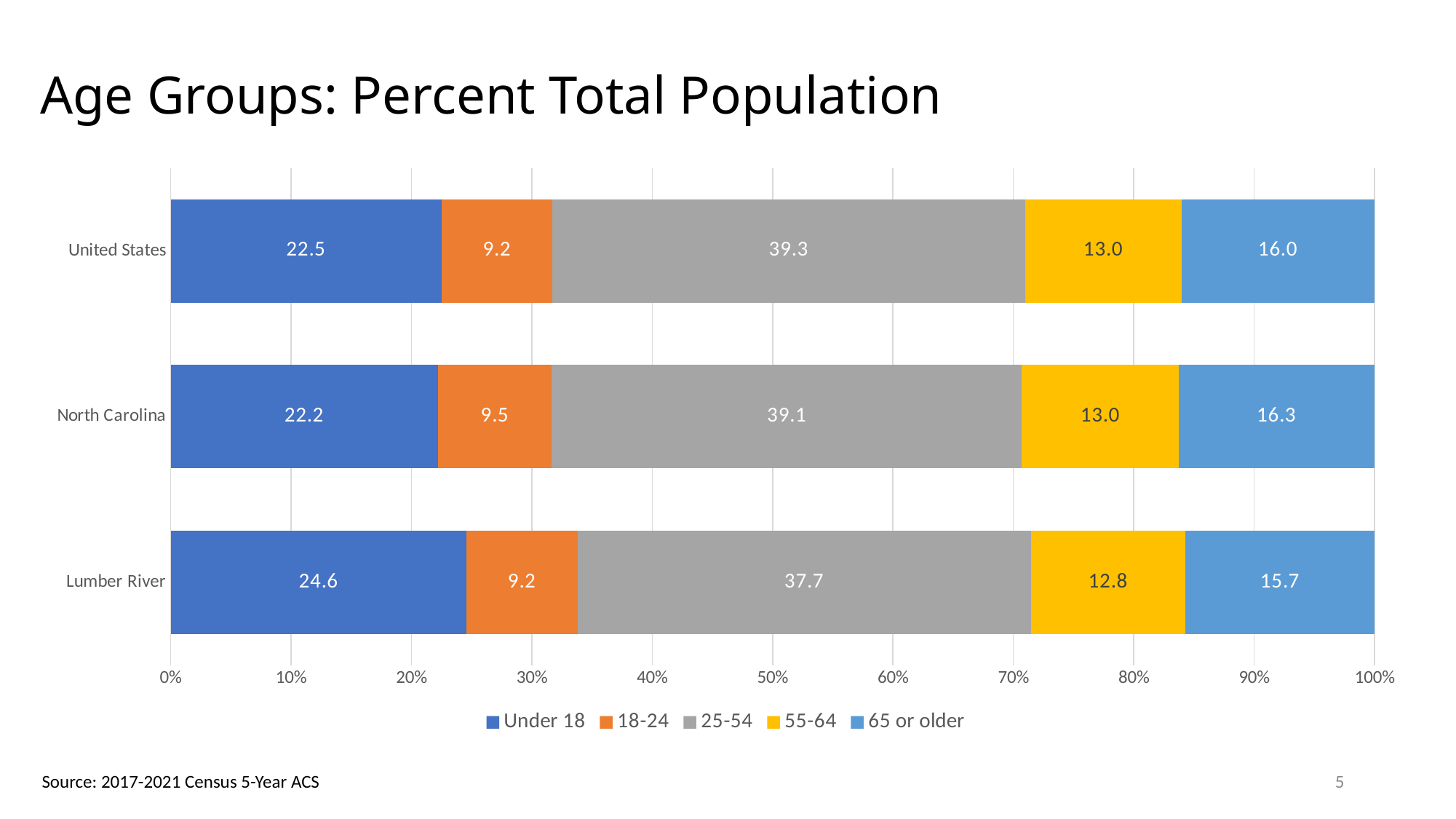
What is the value for the Under 18 age group in Lumber River? 24.6 Which region has the lowest value for the 25-54 age group? Lumber River Which is larger: the 65 or older value for North Carolina or for Lumber River? North Carolina How many age groups does the legend list? 5 What is the value for the 18-24 age group in North Carolina? 9.5 What is the title of the chart? Age Groups: Percent Total Population What is the value for the 25-54 age group in the United States? 39.3 What is the difference between the Under 18 values for Lumber River and the United States? 2.1 Which region has the highest value for the Under 18 age group? Lumber River What is the value for the 65 or older age group in North Carolina? 16.3 What kind of chart is shown on the slide? Stacked bar chart How many regions are shown on the chart? 3